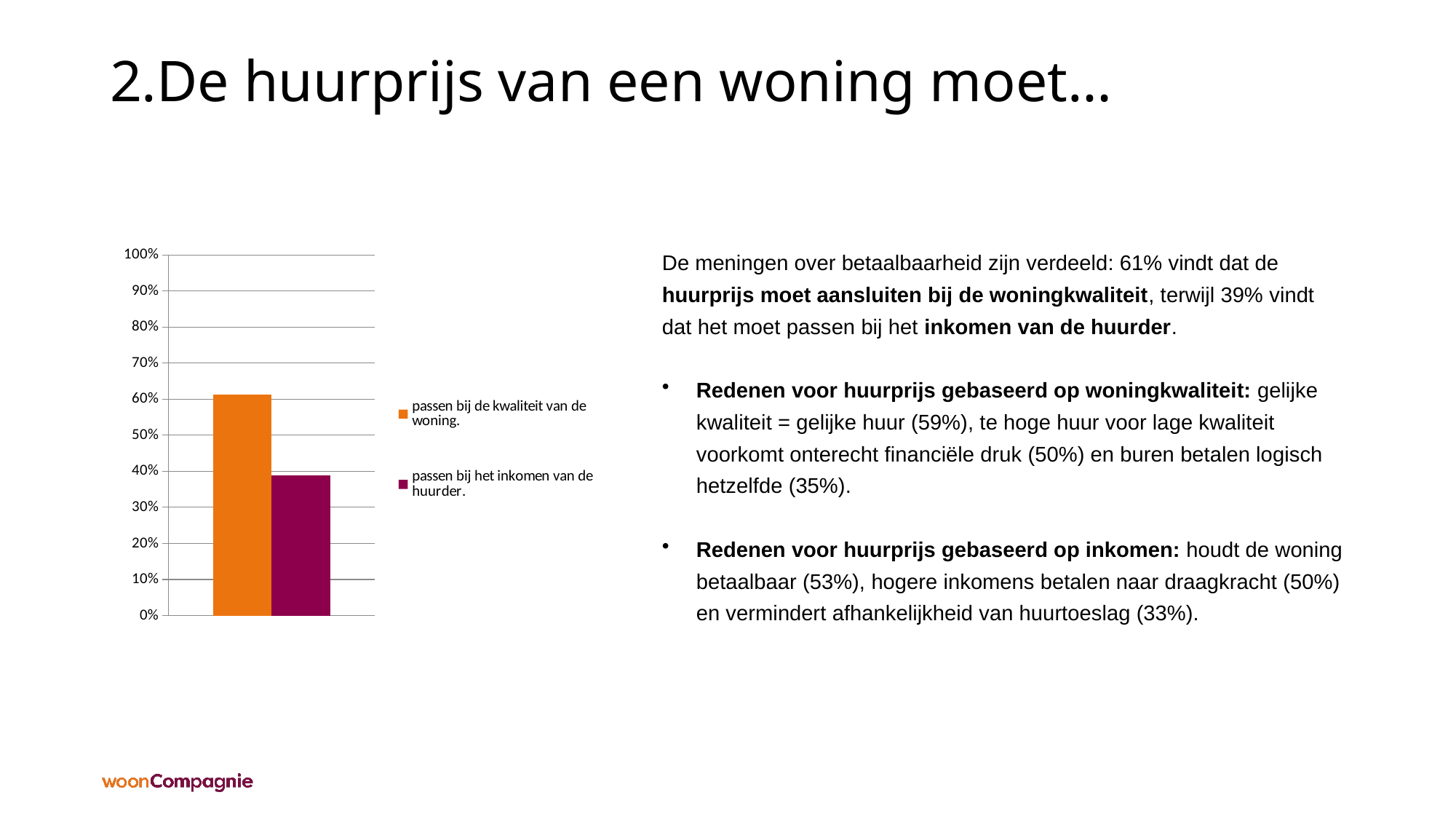
What is the highest value shown on the chart's vertical axis? 100% Which is larger: the bar for 'passen bij de kwaliteit van de woning.' or the bar for 'passen bij het inkomen van de huurder.'? passen bij de kwaliteit van de woning. How many bars are plotted in the chart? 2 Which series has the lowest bar in the chart? passen bij het inkomen van de huurder. What colour is the bar for 'passen bij de kwaliteit van de woning.'? orange Is the value for 'passen bij het inkomen van de huurder.' greater or less than 50%? less How many series does the chart legend list? 2 Is the value for 'passen bij de kwaliteit van de woning.' greater or less than 50%? greater What kind of chart is shown on the slide? bar chart Which series has the highest bar in the chart? passen bij de kwaliteit van de woning. Is the value for 'passen bij het inkomen van de huurder.' greater or less than 30%? greater